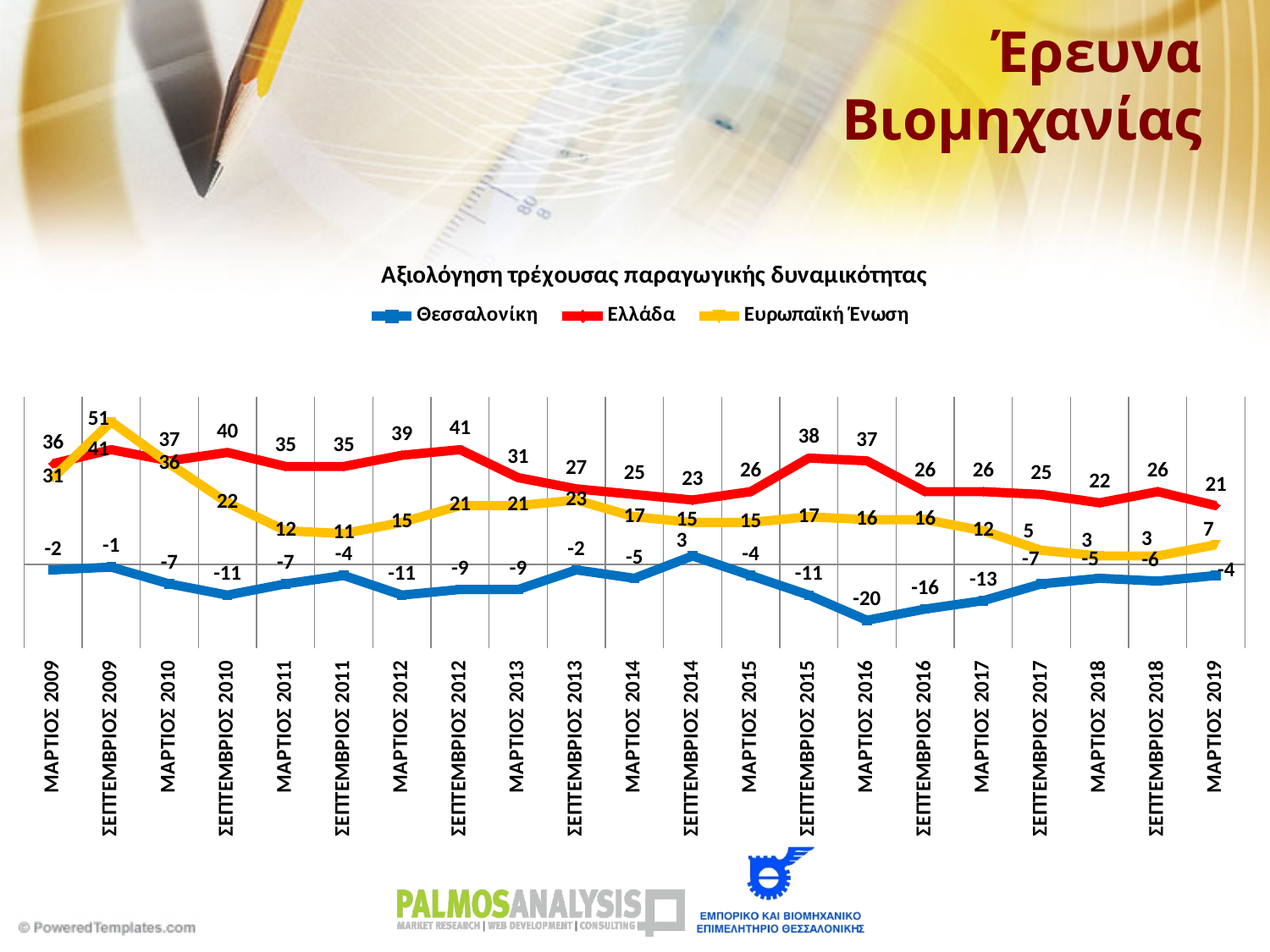
What is the value for Θεσσαλονίκη in ΜΑΡΤΙΟΣ 2016? -20 In which period does Θεσσαλονίκη reach its lowest value? ΜΑΡΤΙΟΣ 2016 What kind of chart is shown on the slide? line chart How many time points are plotted along the x axis? 21 In which period does Ευρωπαϊκή Ένωση reach its highest value? ΣΕΠΤΕΜΒΡΙΟΣ 2009 In ΣΕΠΤΕΜΒΡΙΟΣ 2009, which is higher: Ελλάδα or Ευρωπαϊκή Ένωση? Ευρωπαϊκή Ένωση How many series does the legend list? 3 What is the value for Ελλάδα in ΜΑΡΤΙΟΣ 2019? 21 Does the Ευρωπαϊκή Ένωση series rise or fall from ΣΕΠΤΕΜΒΡΙΟΣ 2009 to ΣΕΠΤΕΜΒΡΙΟΣ 2011? fall What is the difference between Ελλάδα and Θεσσαλονίκη in ΜΑΡΤΙΟΣ 2019? 25 What is the title of the chart? Αξιολόγηση τρέχουσας παραγωγικής δυναμικότητας What is the value for Ευρωπαϊκή Ένωση in ΣΕΠΤΕΜΒΡΙΟΣ 2017? 5